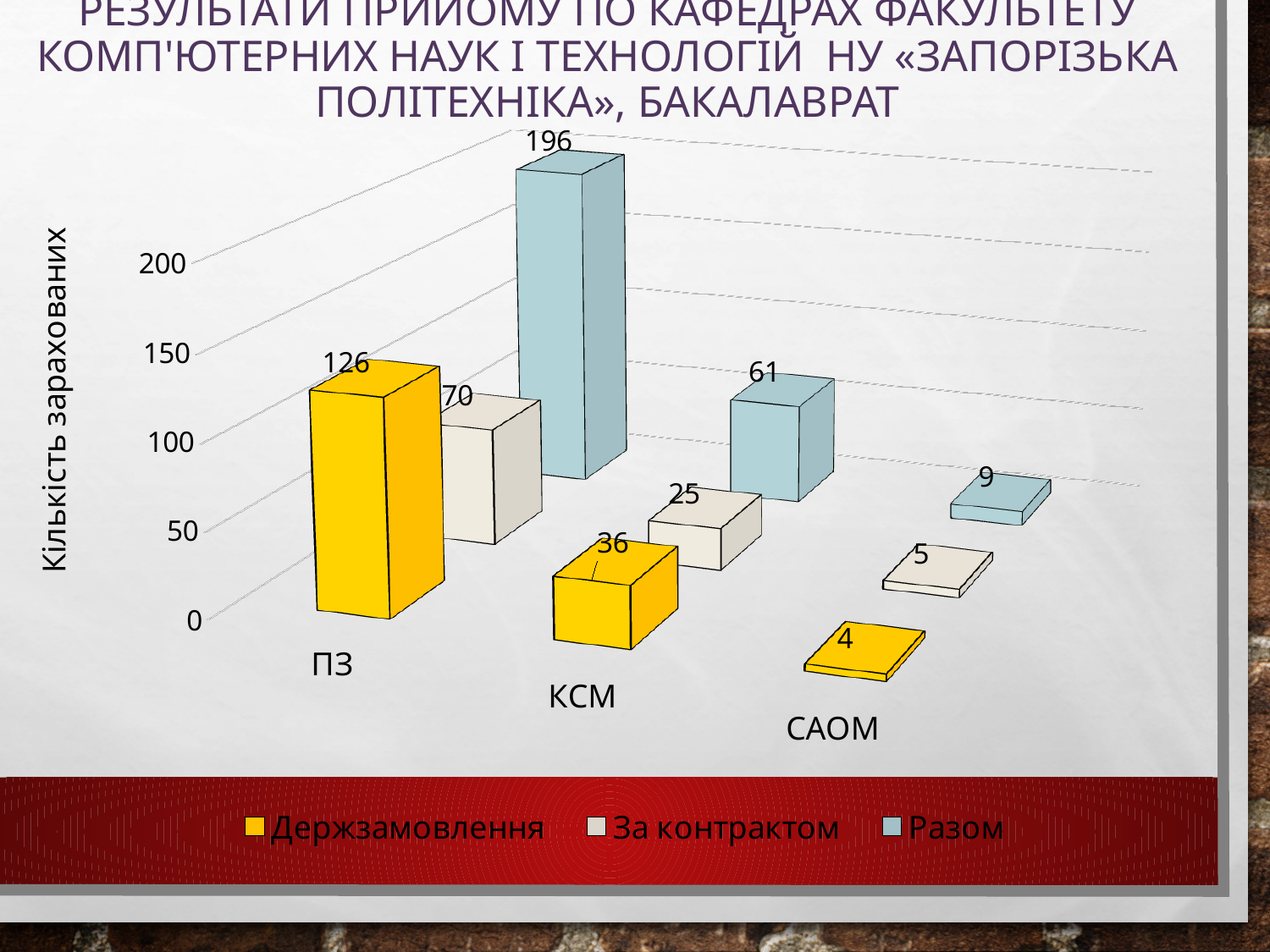
Which is larger for САОМ: Держзамовлення or За контрактом? За контрактом What kind of chart is shown on the slide? Bar chart What is the value of За контрактом for КСМ? 25 What is the value of Разом for ПЗ? 196 Which category has the highest Разом value? ПЗ How many series does the legend list? 3 What is the value of Разом for САОМ? 9 What is the difference between Держзамовлення and За контрактом for ПЗ? 56 How many categories are shown on the x axis? 3 What is the value of Держзамовлення for ПЗ? 126 Which category has the lowest Держзамовлення value? САОМ What is the label of the vertical axis? Кількість зарахованих